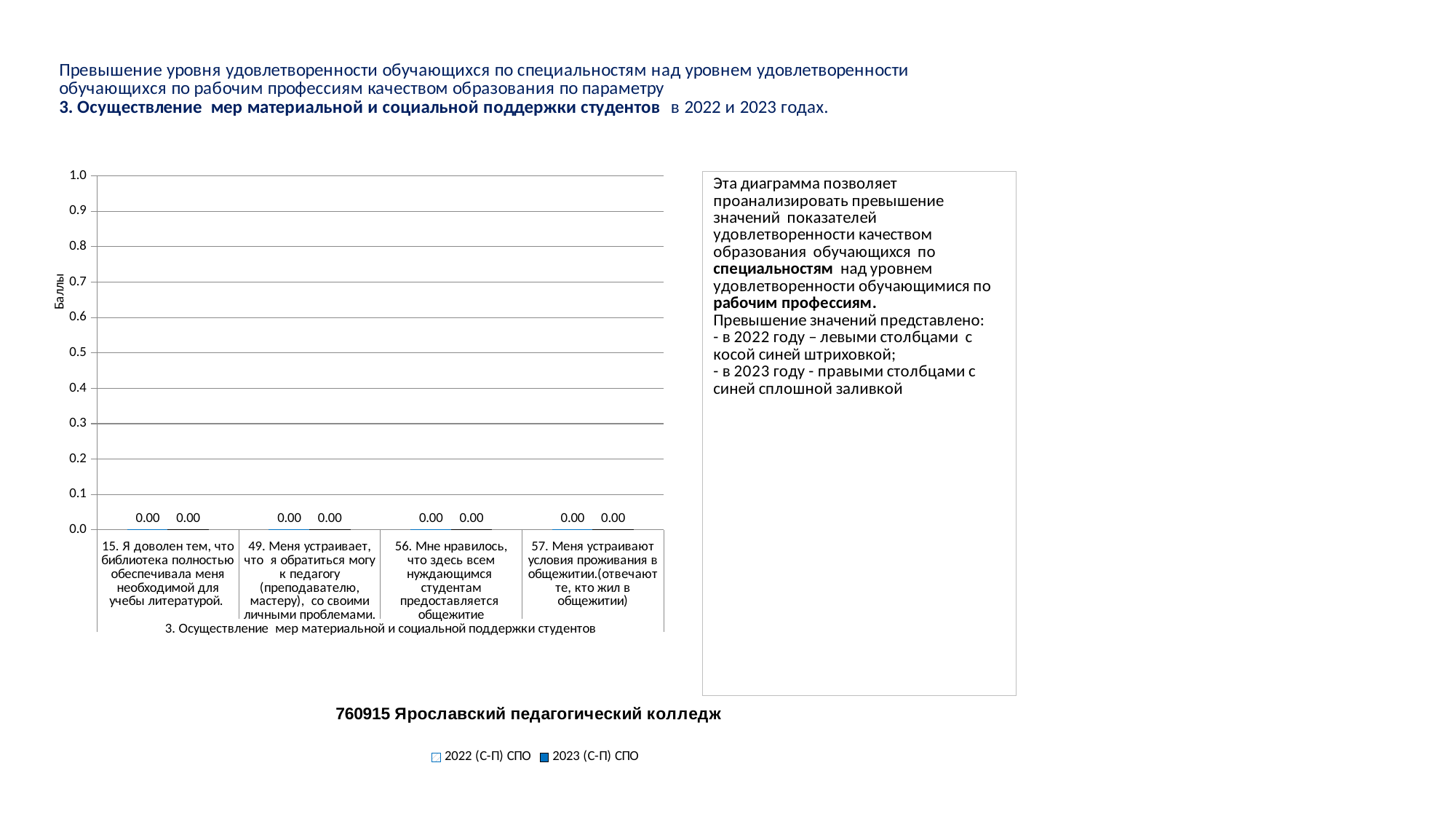
What is the label of the vertical axis of the chart? Баллы What is the value of the 2022 (С-П) СПО series for category 15 (Я доволен тем, что библиотека полностью обеспечивала меня необходимой для учебы литературой)? 0.00 What is the highest value shown on the vertical axis of the chart? 1.0 What is the value of the 2022 (С-П) СПО series for category 56 (Мне нравилось, что здесь всем нуждающимся студентам предоставляется общежитие)? 0.00 How many series does the chart legend list? 2 Is the value of the 2023 (С-П) СПО series for category 56 greater or less than 0.5? less What is the difference between the 2022 (С-П) СПО and 2023 (С-П) СПО values for category 15? 0.00 How many categories are shown on the x axis of the chart? 4 What type of chart is shown on the slide? bar chart What is the value of the 2023 (С-П) СПО series for category 57 (Меня устраивают условия проживания в общежитии)? 0.00 What is the value of the 2023 (С-П) СПО series for category 49 (Меня устраивает, что я обратиться могу к педагогу со своими личными проблемами)? 0.00